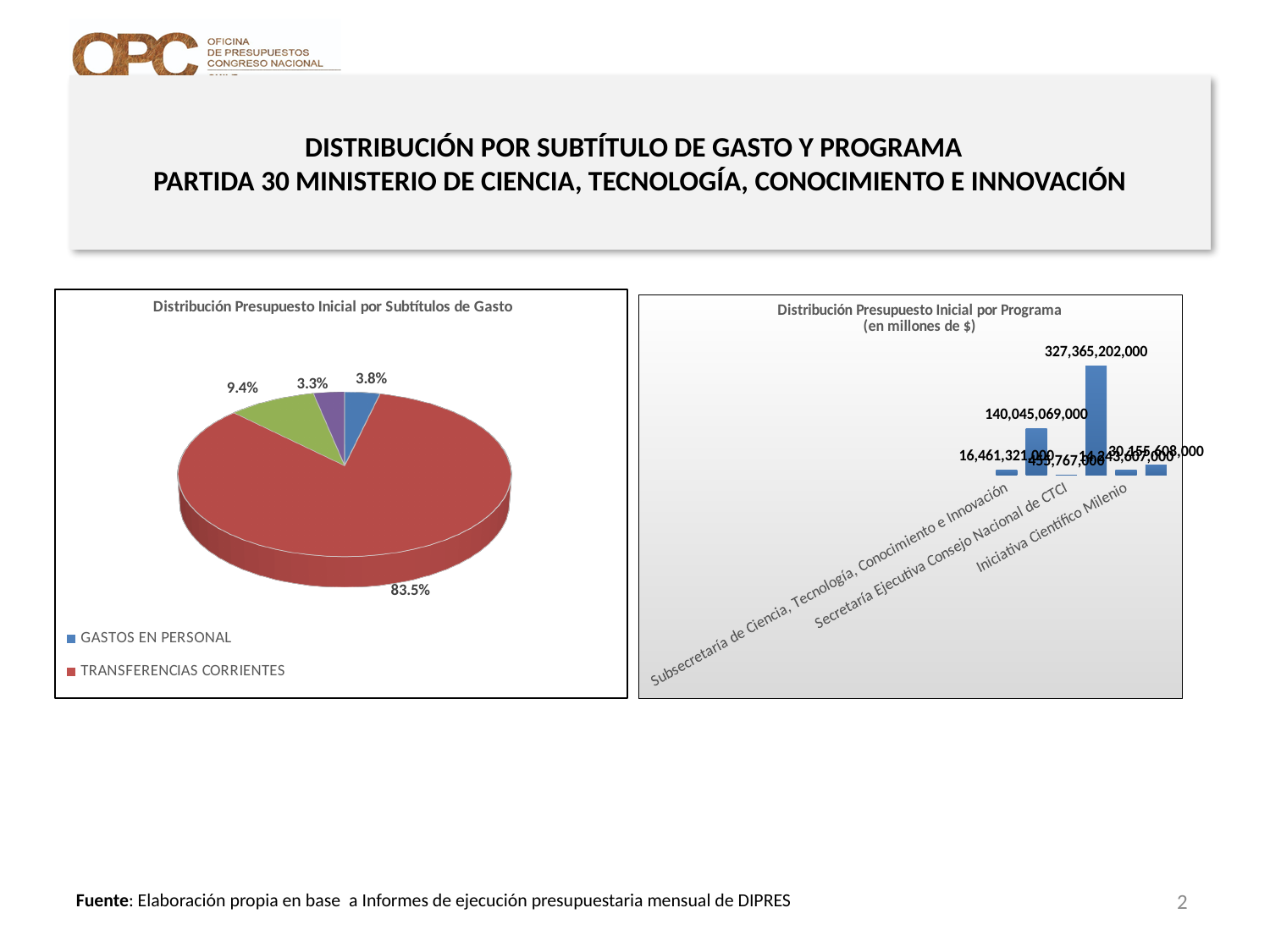
On the left pie chart, which legend category has the largest slice? TRANSFERENCIAS CORRIENTES What kind of chart is the left chart on the slide? Pie chart What kind of chart is the right chart (Distribución Presupuesto Inicial por Programa)? Bar chart How many entries does the legend of the left pie chart list? 2 How many bars are plotted on the right chart (Distribución Presupuesto Inicial por Programa)? 6 On the left chart (Distribución Presupuesto Inicial por Subtítulos de Gasto), what share does TRANSFERENCIAS CORRIENTES have? 83.5% On the right chart (Distribución Presupuesto Inicial por Programa), what is the highest value shown? 327,365,202,000 On the right chart (Distribución Presupuesto Inicial por Programa), what is the value for Subsecretaría de Ciencia, Tecnología, Conocimiento e Innovación? 16,461,321,000 On the left pie chart, what is the difference in percentage points between TRANSFERENCIAS CORRIENTES and GASTOS EN PERSONAL? 79.7 percentage points On the left chart (Distribución Presupuesto Inicial por Subtítulos de Gasto), what share does GASTOS EN PERSONAL have? 3.8% How many slices does the left pie chart have? 4 On the left pie chart, what is the smallest percentage shown? 3.3%